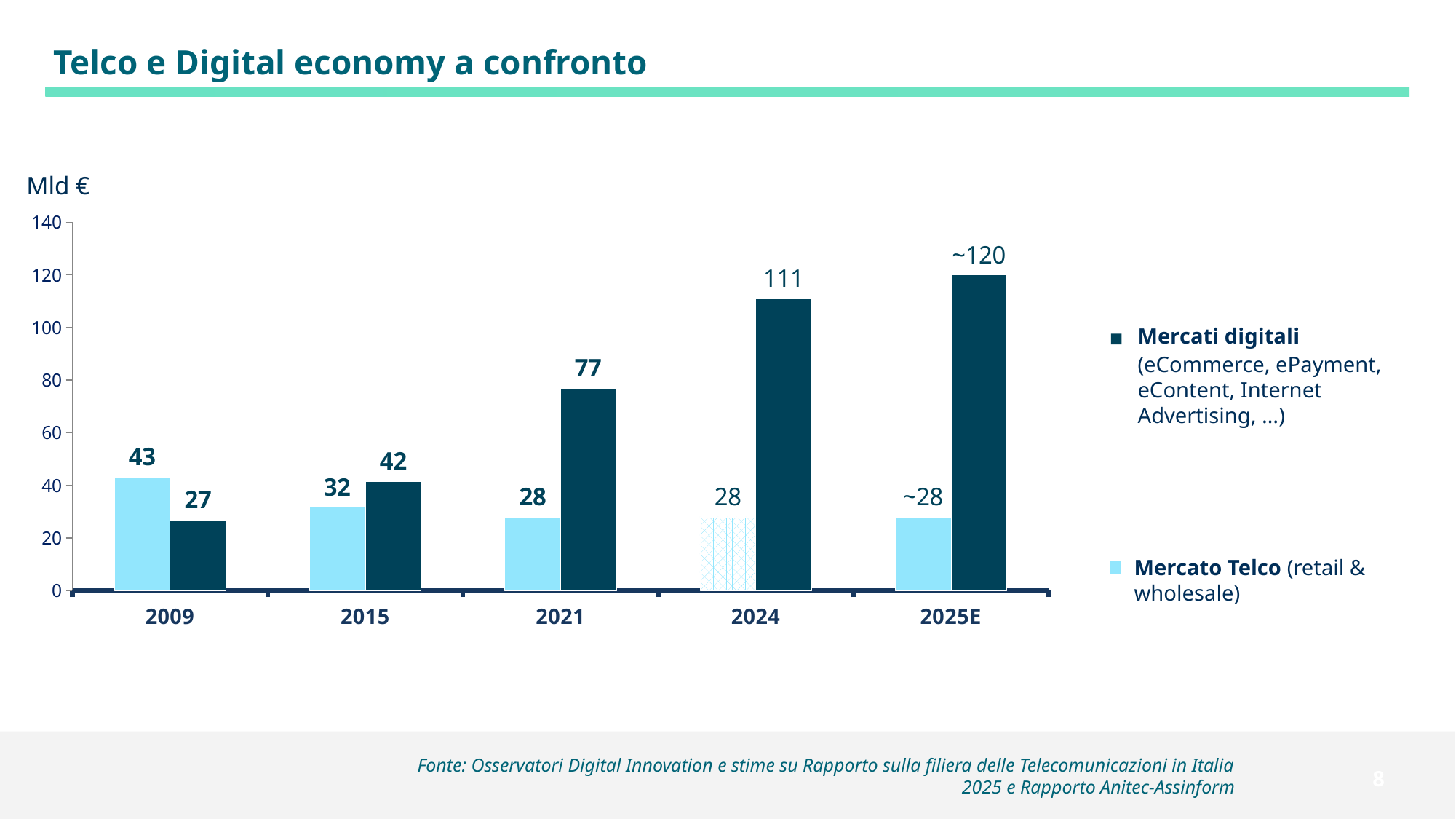
What is the difference between Mercati digitali and Mercato Telco in 2024? 83 What is the value for Mercati digitali in 2024? 111 What kind of chart is shown on the slide? bar chart In which year is the Mercato Telco value highest? 2009 What is the value for Mercato Telco in 2009? 43 Is the value for Mercati digitali in 2024 greater or less than 100? greater How many series does the legend list? 2 How many years are shown on the x axis? 5 Do the Mercati digitali values rise or fall from 2009 to 2025E? rise What is the value for Mercati digitali in 2021? 77 In 2009, which is larger: Mercato Telco or Mercati digitali? Mercato Telco In which year is the Mercati digitali value lowest? 2009